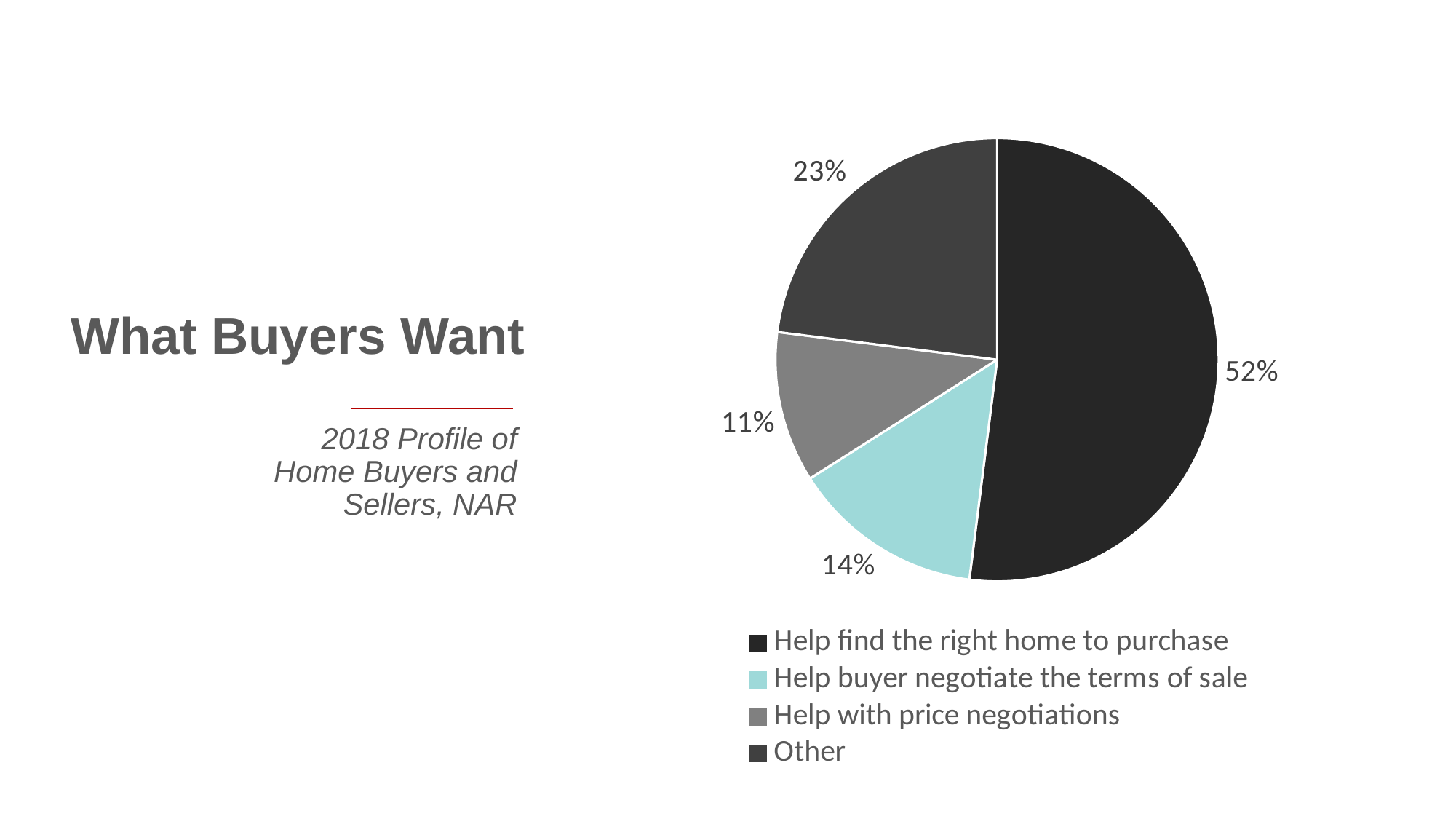
How many slices does the pie chart have? 4 What share of the pie is 'Help find the right home to purchase'? 52% What share of the pie is 'Help with price negotiations'? 11% Which is larger: 'Help buyer negotiate the terms of sale' or 'Help with price negotiations'? Help buyer negotiate the terms of sale What share of the pie is 'Help buyer negotiate the terms of sale'? 14% What share of the pie is 'Other'? 23% Which category has the smallest slice of the pie? Help with price negotiations Which legend entry is shown in light teal? Help buyer negotiate the terms of sale What is the difference between the 'Help find the right home to purchase' share and the 'Other' share? 29% How many entries does the legend list? 4 Which category has the largest slice of the pie? Help find the right home to purchase What kind of chart is shown on the slide? pie chart